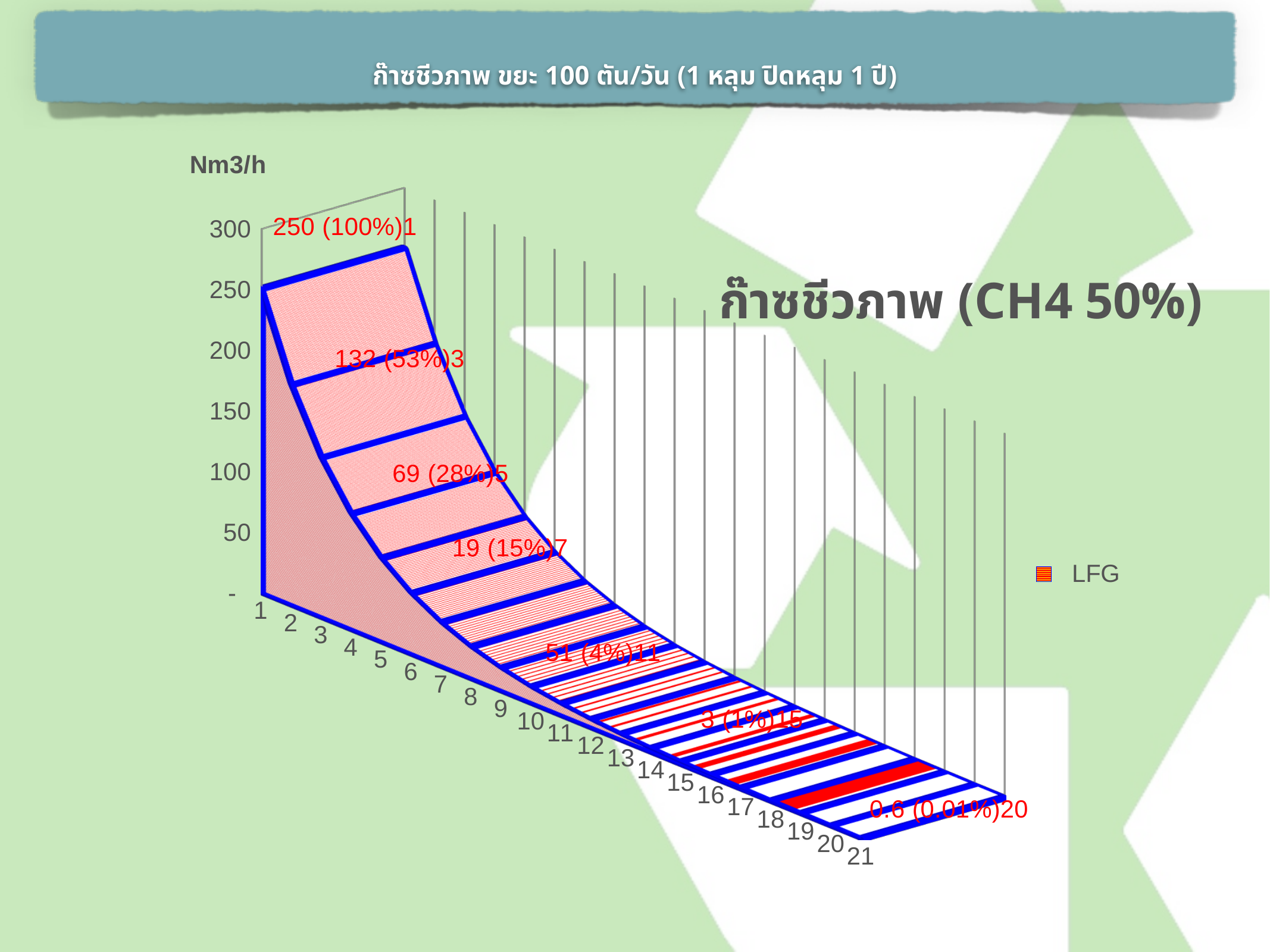
What kind of chart is shown on the slide? Area chart Do the values rise or fall as the years increase along the x axis? Fall How many years are shown on the x axis? 21 What value is labelled for year 1 on the chart? 250 (100%) What value is labelled for year 20 on the chart? 0.6 (0.01%) Which is larger, the value for year 3 or the value for year 5? Year 3 What value is labelled for year 3 on the chart? 132 (53%) How many series does the legend list? 1 What value is labelled for year 5 on the chart? 69 (28%) Is the value for year 10 greater or less than 50? less What is the difference between the labelled values for year 1 and year 3? 118 Which year has the highest LFG value? 1